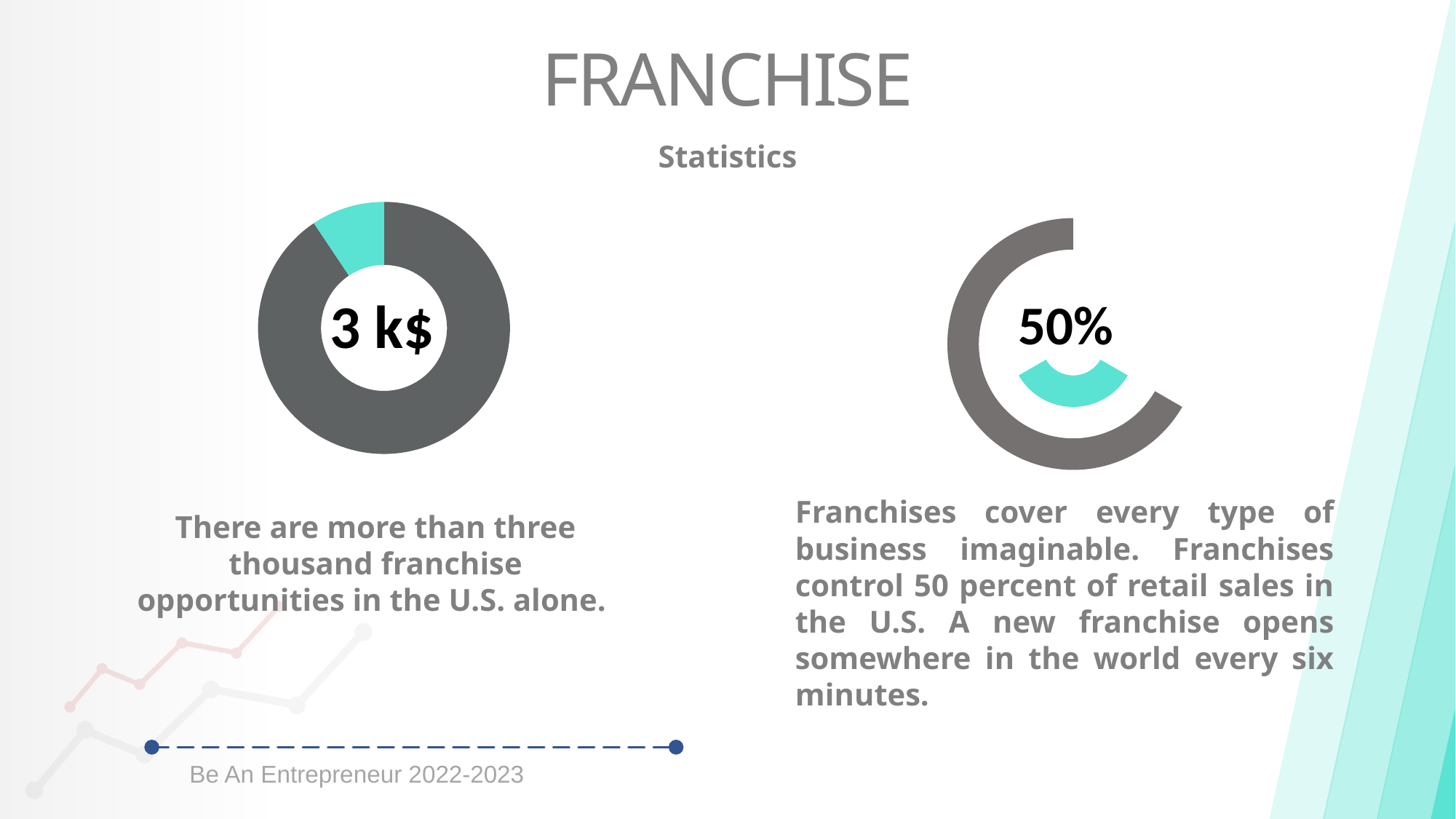
What kind of chart is the chart on the left of the slide? doughnut chart How many slices does the left doughnut chart have? 2 What value is printed in the centre of the left chart? 3 k$ What value is printed in the centre of the right chart? 50% In the left chart, which slice is larger, the grey one or the teal one? grey How many charts are shown on the slide? 2 What colour is the smaller slice of the left chart? teal What colour is the larger arc of the right chart? grey In the right chart, which arc is larger, the grey one or the teal one? grey